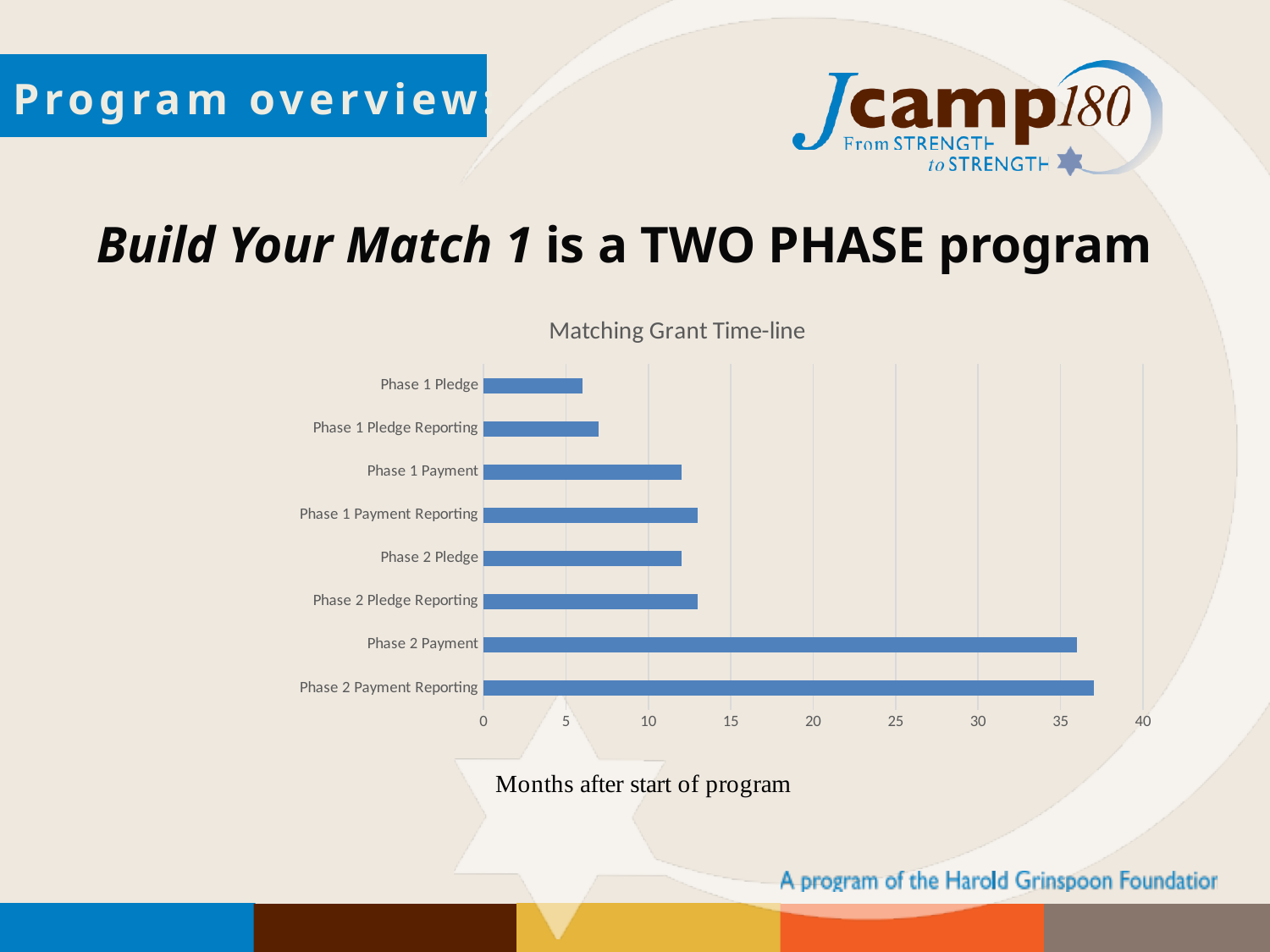
Which is larger, the value for Phase 1 Pledge or the value for Phase 1 Payment Reporting? Phase 1 Payment Reporting Is the value for Phase 2 Payment Reporting greater or less than 40? less What is the title of the chart? Matching Grant Time-line Which category has the shortest bar in the chart? Phase 1 Pledge How many categories are plotted in the chart? 8 Which category has the longest bar in the chart? Phase 2 Payment Reporting What kind of chart is shown on the slide? bar chart Is the value for Phase 1 Pledge greater or less than 10? less What does the horizontal axis of the chart measure, according to the label below it? Months after start of program Is the value for Phase 1 Payment greater or less than 10? greater Which is larger, the value for Phase 2 Payment or the value for Phase 1 Payment? Phase 2 Payment